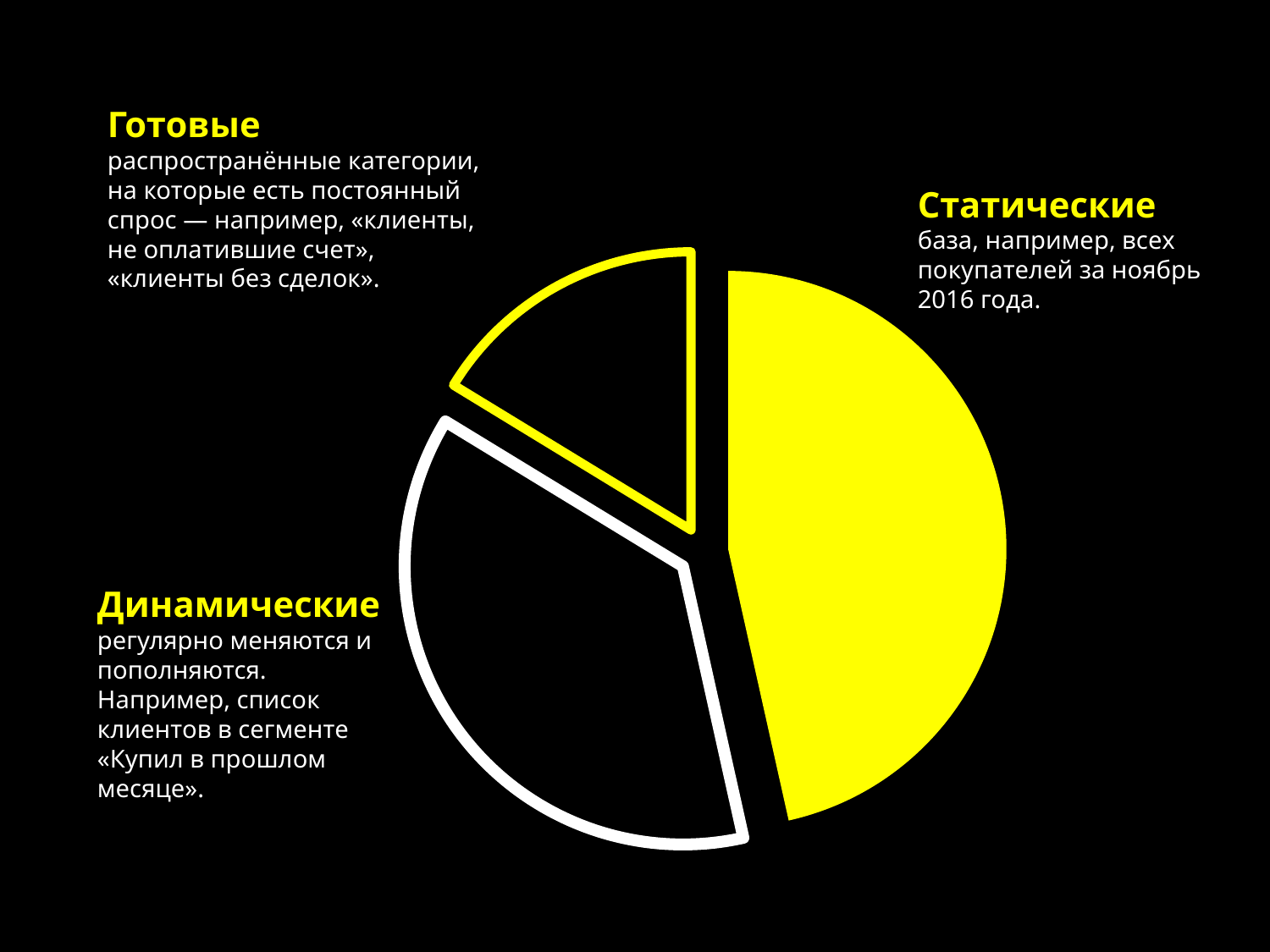
How many slices does the pie chart have? 3 Which category has the smallest slice of the pie? Готовые Which category is shown as a slice with a white outline? Динамические Which category is shown as a solid yellow slice? Статические Which slice is larger, Статические or Динамические? Статические What kind of chart is shown on the slide? pie chart Which category has the largest slice of the pie? Статические Which slice is larger, Динамические or Готовые? Динамические